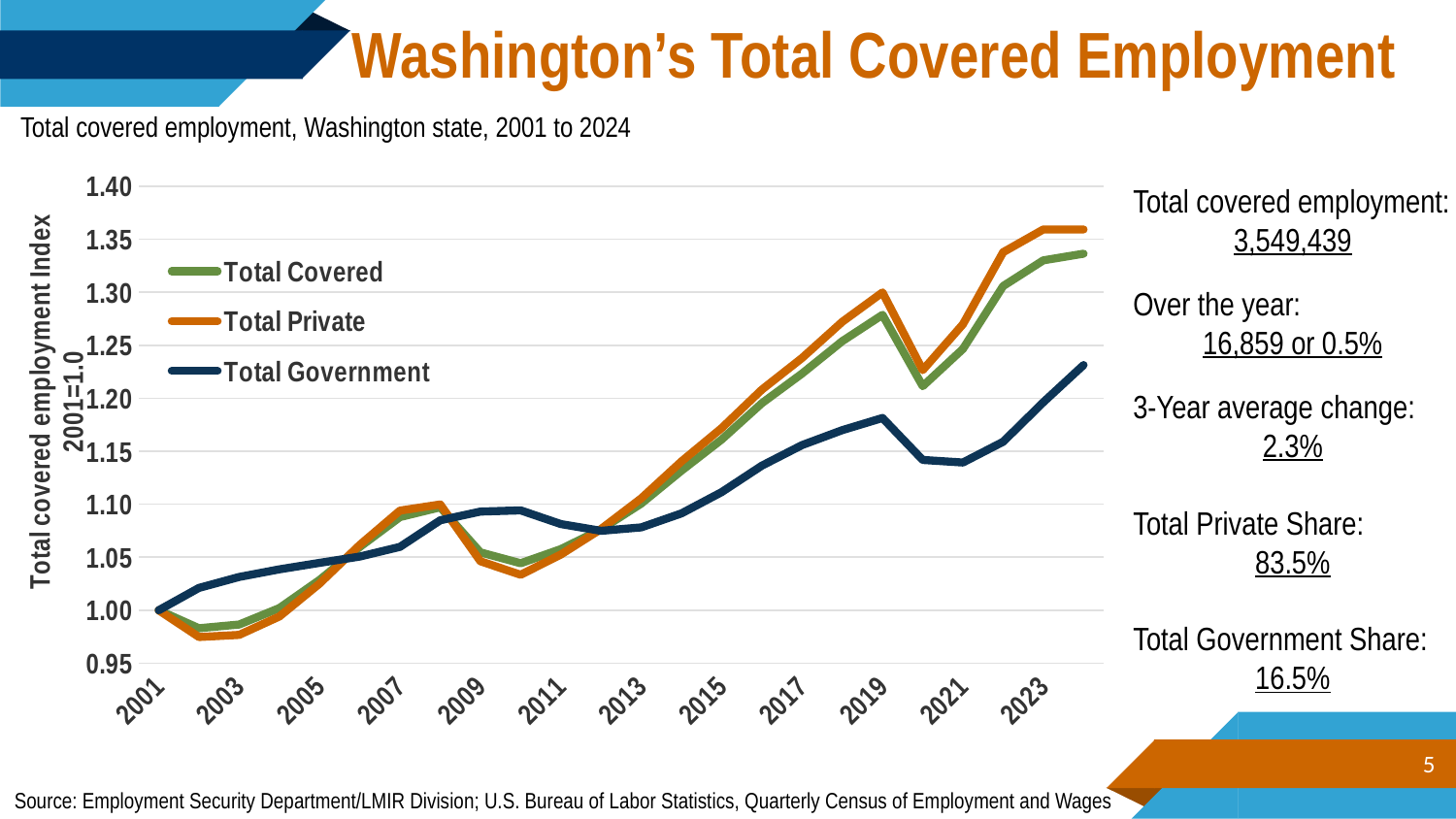
Is the value for Total Covered in 2019 greater or less than 1.25? greater Does the Total Private line rise or fall between 2019 and 2020? Fall What are the three series named in the chart's legend? Total Covered, Total Private, Total Government In 2009, which series has the higher value, Total Government or Total Private? Total Government Is the value for Total Government in 2024 greater or less than 1.25? less Is the value for Total Private in 2024 greater or less than 1.30? greater How many series does the chart's legend list? 3 Which series has the lowest value in 2023? Total Government What is the index value for Total Government in 2001? 1.00 What kind of chart is shown on the slide? Line chart Which series has the highest value in 2023? Total Private